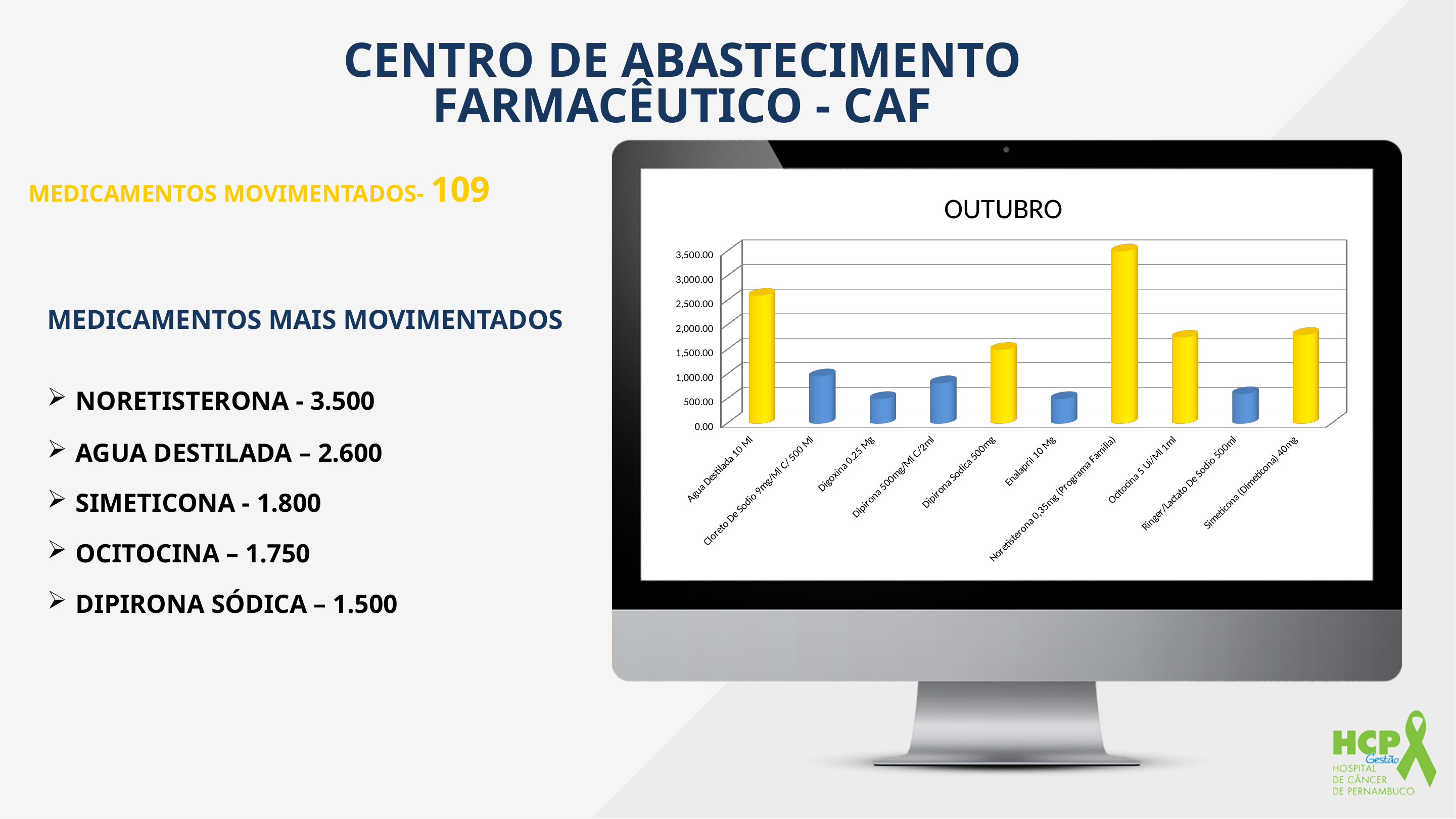
What is the title of the chart? OUTUBRO What is the value for Dipirona Sodica 500mg? 1,500.00 How many categories are plotted on the chart? 10 Is the value for Agua Destilada 10 Ml greater or less than 2,500.00? greater What is the value for Noretisterona 0,35mg (Programa Familia)? 3,500.00 Which is larger, the value for Agua Destilada 10 Ml or the value for Simeticona (Dimeticona) 40mg? Agua Destilada 10 Ml What is the difference between the values for Noretisterona 0,35mg (Programa Familia) and Dipirona Sodica 500mg? 2,000.00 What colour are the bars for the five highest categories on the chart? yellow What kind of chart is shown on the slide? bar chart Which category has the highest value on the chart? Noretisterona 0,35mg (Programa Familia) Is the value for Ringer/Lactato De Sodio 500ml greater or less than 1,000.00? less